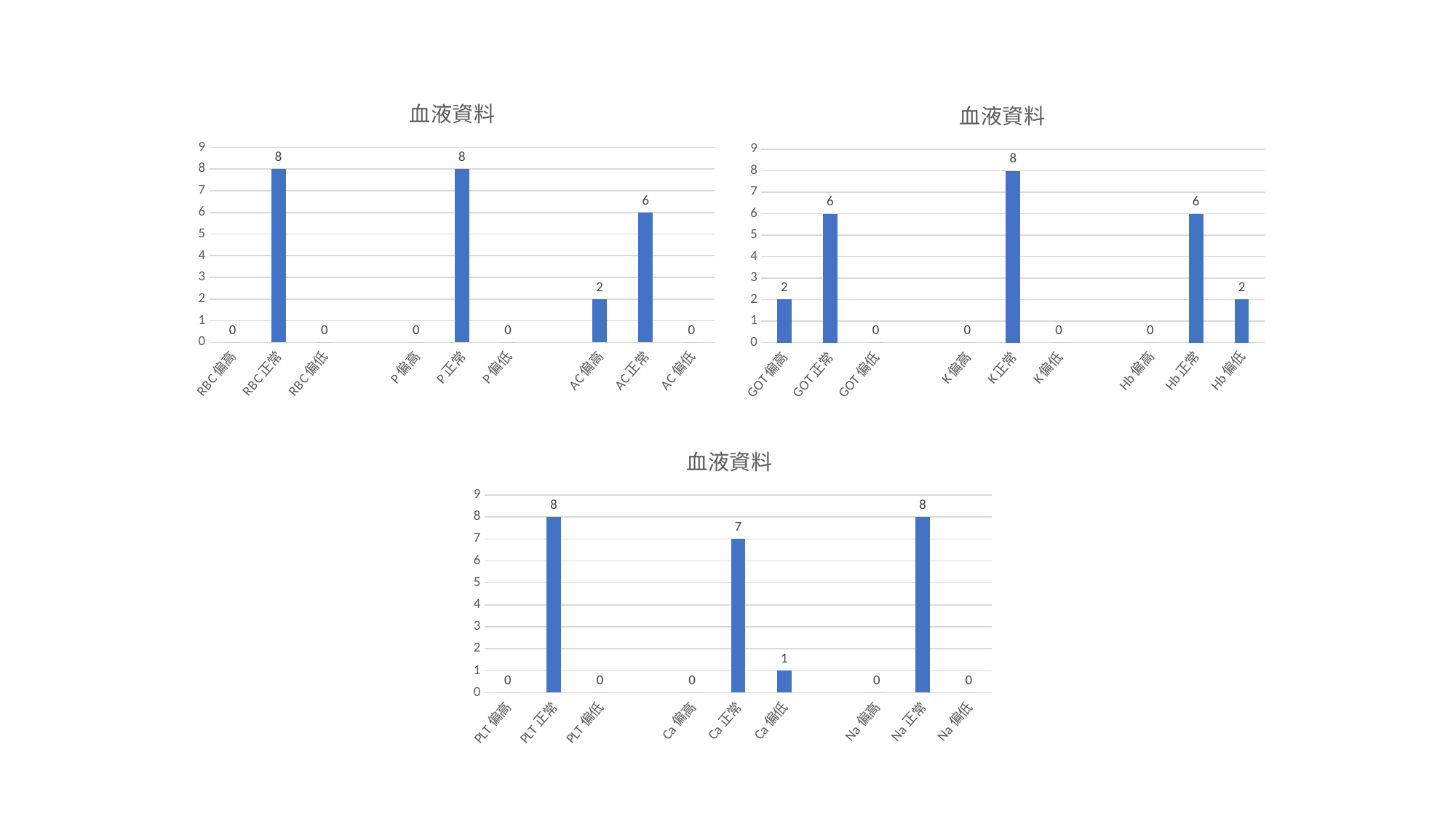
In the top-right chart, which category has the highest value? K 正常 In the bottom chart, what is the value for Ca 正常? 7 What kind of chart is the top-left chart? bar chart In the top-right chart, what is the value for Hb 偏低? 2 In the top-left chart, what is the value for AC 正常? 6 In the bottom chart, what is the difference between PLT 正常 and Ca 正常? 1 In the bottom chart, what is the value for Ca 偏低? 1 What is the title of the bottom chart? 血液資料 In the top-right chart, which is larger, GOT 正常 or K 正常? K 正常 In the top-left chart, what is the difference between P 正常 and AC 正常? 2 In the top-left chart, what is the value for AC 偏高? 2 How many categories are shown on the x axis of the bottom chart? 9